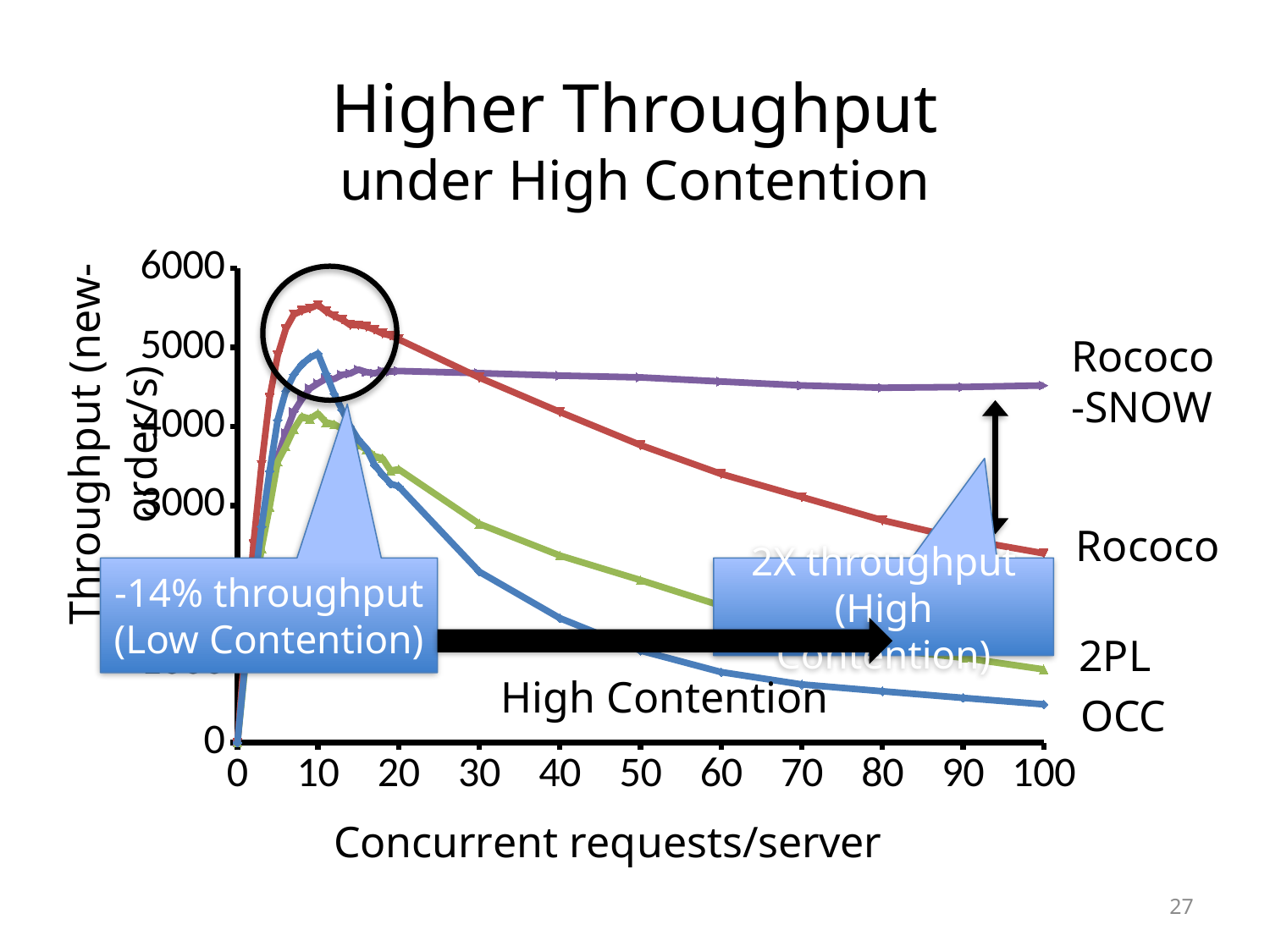
Is the peak throughput of Rococo greater or less than 5000? greater Which series has the highest throughput at 100 concurrent requests/server? Rococo-SNOW At 100 concurrent requests/server, which has higher throughput, Rococo-SNOW or Rococo? Rococo-SNOW Which series has the lowest throughput at 100 concurrent requests/server? OCC How many series are plotted on the chart? 4 Does the throughput of OCC rise or fall as concurrent requests/server increase from 10 to 100? fall Is the throughput of Rococo at 100 concurrent requests/server greater or less than 3000? less What kind of chart is shown on the slide? line chart Is the throughput of Rococo-SNOW at 100 concurrent requests/server greater or less than 4000? greater What is the label of the x axis? Concurrent requests/server At 10 concurrent requests/server, which has higher throughput, Rococo or Rococo-SNOW? Rococo